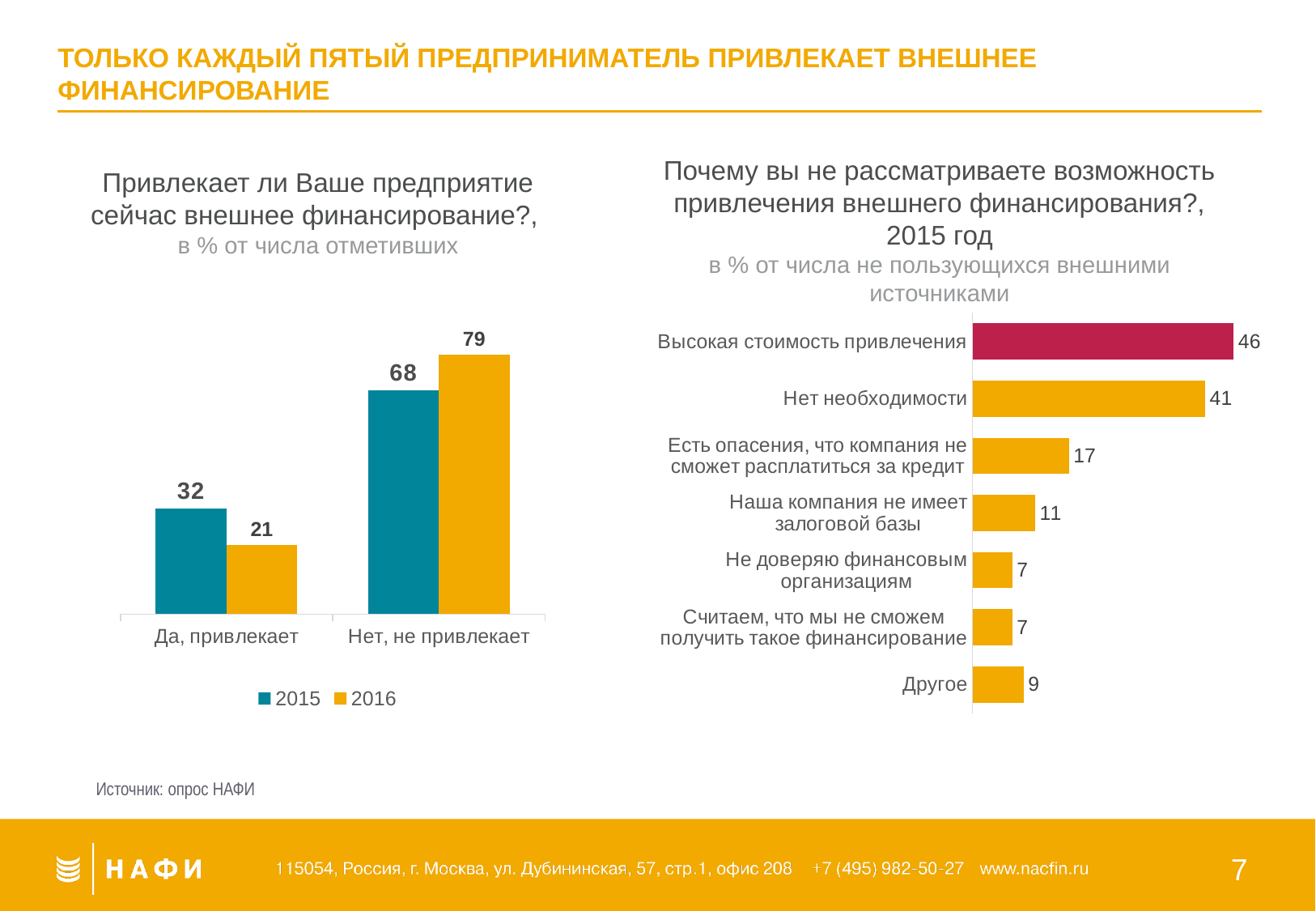
In the right chart (Почему вы не рассматриваете возможность привлечения внешнего финансирования?), what is the value for 'Нет необходимости'? 41 How many series does the legend of the left chart list? 2 In the right chart, what is the difference between 'Высокая стоимость привлечения' and 'Нет необходимости'? 5 In the left chart (Привлекает ли Ваше предприятие сейчас внешнее финансирование?), what is the 2016 value for 'Да, привлекает'? 21 What kind of chart is the left chart? Bar chart In the left chart, what is the 2015 value for 'Нет, не привлекает'? 68 In the right chart, what is the value for 'Наша компания не имеет залоговой базы'? 11 In the left chart, which is larger for 'Нет, не привлекает': the 2015 value or the 2016 value? 2016 In the right chart, which bar is coloured differently from the others? Высокая стоимость привлечения How many categories are shown in the right chart? 7 In the left chart, what is the difference between the 2015 and 2016 values for 'Да, привлекает'? 11 In the right chart, which category has the highest value? Высокая стоимость привлечения